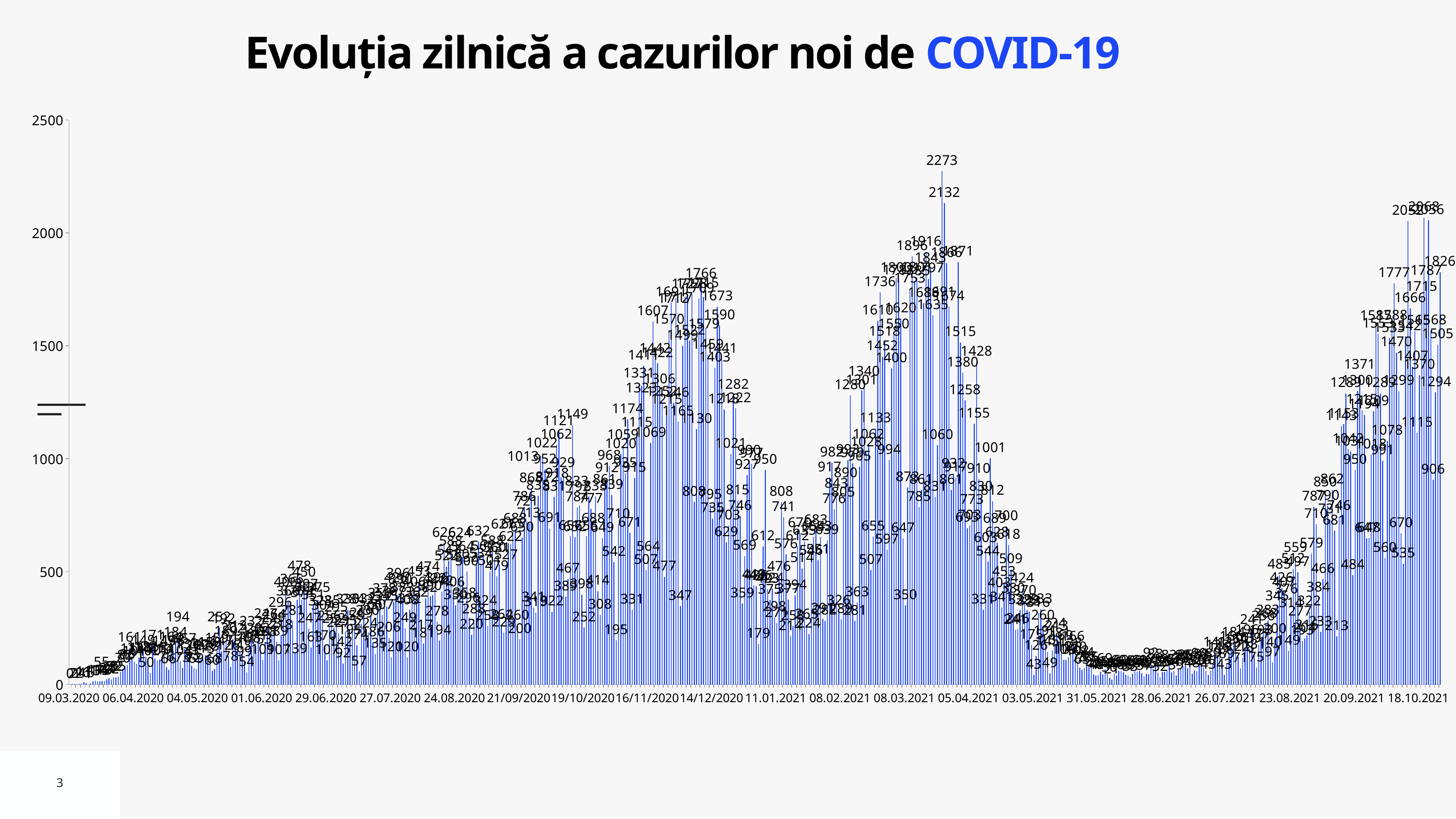
What kind of chart is shown on the slide? bar chart What is the highest daily value labelled on the chart? 2273 Are the daily values around 09.03.2020 greater or less than 500? less What is the difference between the two highest labelled values, 2273 and 2132? 141 Do the values rise or fall between 26.07.2021 and 18.10.2021? rise Do the values rise or fall between 05.04.2021 and 31.05.2021? fall What is the title of the chart? Evoluția zilnică a cazurilor noi de COVID-19 Are the daily values around 31.05.2021 greater or less than 500? less What is the highest value shown on the vertical axis? 2500 Is the highest value on the chart greater or less than 2000? greater Which is larger, the peak of the spring 2021 wave (2273) or the peak of the December 2020 wave (1766)? 2273